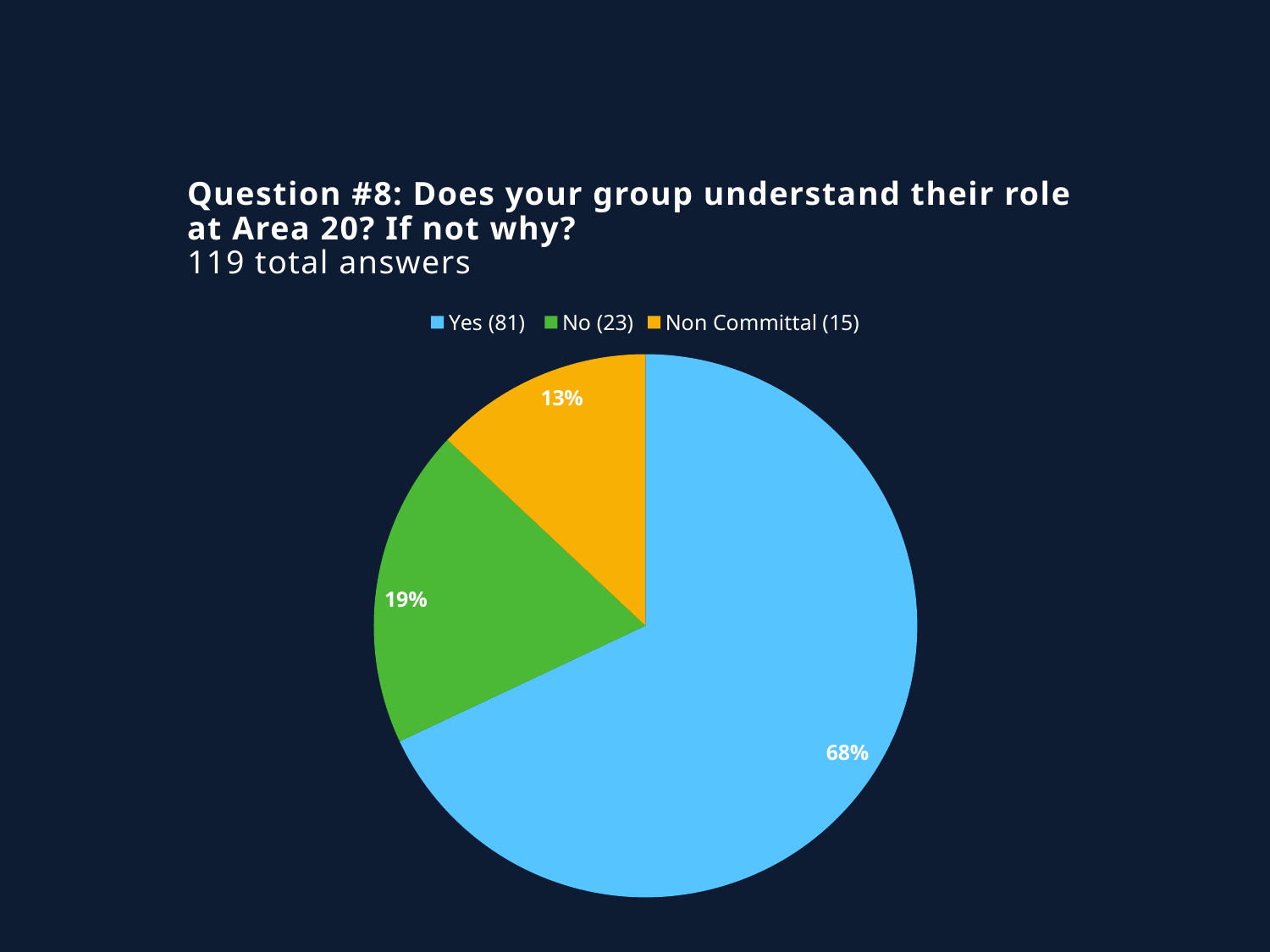
How many answers does the legend show for No? 23 Which colour represents the Non Committal slice? orange Which category has the smallest slice of the pie? Non Committal What percentage of the pie does the Non Committal slice represent? 13% How many answers does the legend show for Non Committal? 15 What kind of chart is shown on the slide? pie chart What percentage of the pie does the No slice represent? 19% What is the difference in percentage points between the Yes slice and the No slice? 49% What percentage of the pie does the Yes slice represent? 68% How many categories does the pie chart have? 3 Which category has the largest slice of the pie? Yes How many answers does the legend show for Yes? 81